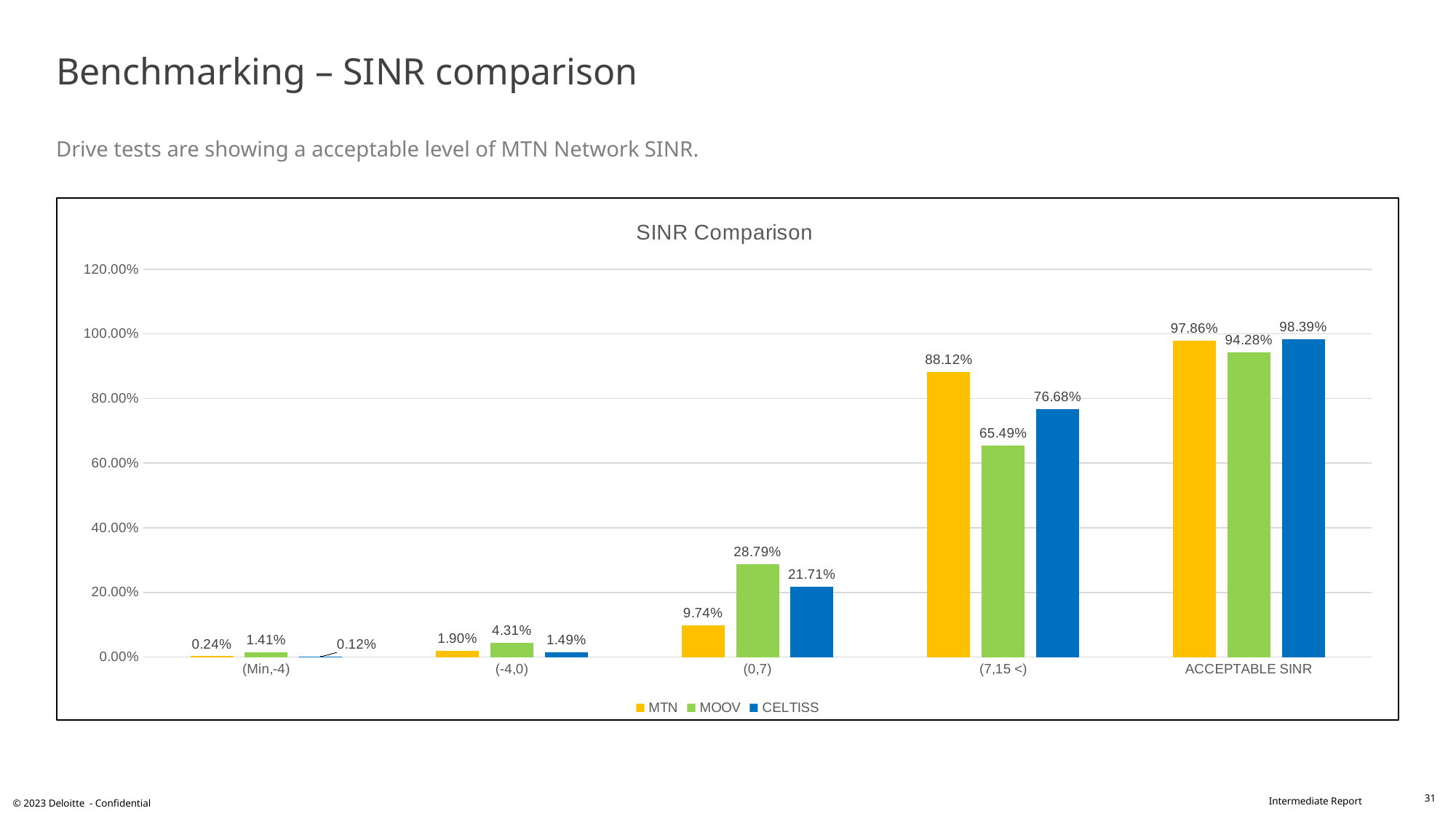
How many series does the legend list? 3 Is the CELTISS value for (7,15 <) greater or less than 80.00%? less What is the difference between the MTN and MOOV values in the (7,15 <) category? 22.63% What kind of chart is shown? bar chart Which is larger for ACCEPTABLE SINR, MTN or MOOV? MTN What is the MOOV value for the (0,7) category? 28.79% Which operator has the highest value in the (7,15 <) category? MTN What is the CELTISS value for ACCEPTABLE SINR? 98.39% Which operator has the lowest value in the (Min,-4) category? CELTISS How many categories are shown on the x axis? 5 What is the title of the chart? SINR Comparison What is the MTN value for the (7,15 <) category? 88.12%